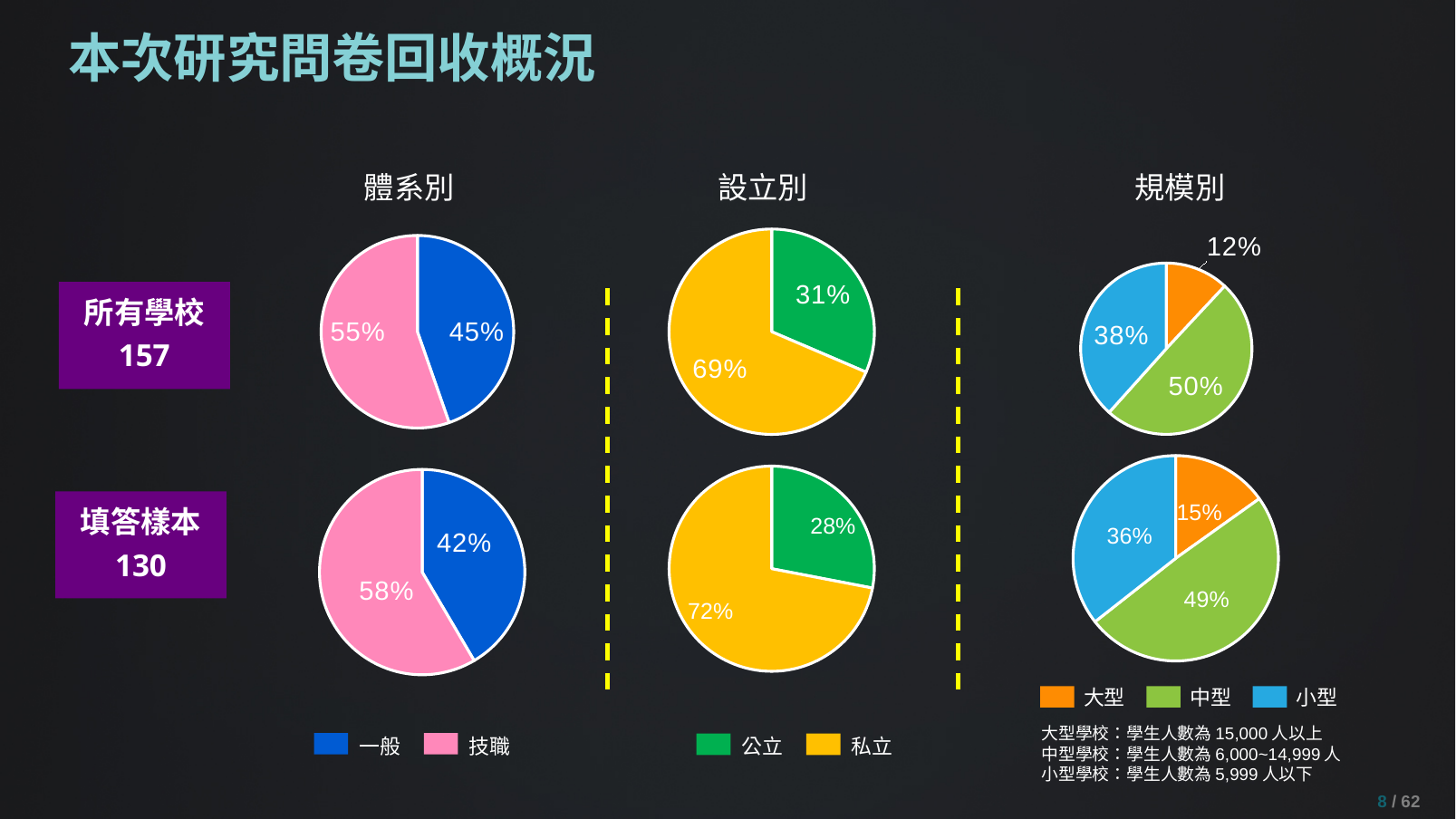
In the 設立別 pie chart for the 填答樣本 row, what share is 公立? 28% In the 設立別 pie chart for the 填答樣本 row, what is the difference between the 私立 and 公立 shares? 44% In the 設立別 pie chart for the 所有學校 row, what share is 私立? 69% What type of chart is used for the 設立別 column? Pie chart How many slices does the 規模別 pie chart for the 填答樣本 row have? 3 In the 規模別 pie chart for the 所有學校 row, which category has the smallest share? 大型 In the 體系別 pie chart for the 所有學校 row, which is larger, 一般 or 技職? 技職 In the 體系別 pie chart for the 填答樣本 row, what share is 技職? 58% In the 規模別 pie chart for the 填答樣本 row, which category has the largest share? 中型 How many entries does the legend for the 規模別 charts list? 3 In the 規模別 pie chart for the 所有學校 row, what share is 大型? 12% In the 體系別 pie chart for the 所有學校 row, what share is 一般? 45%